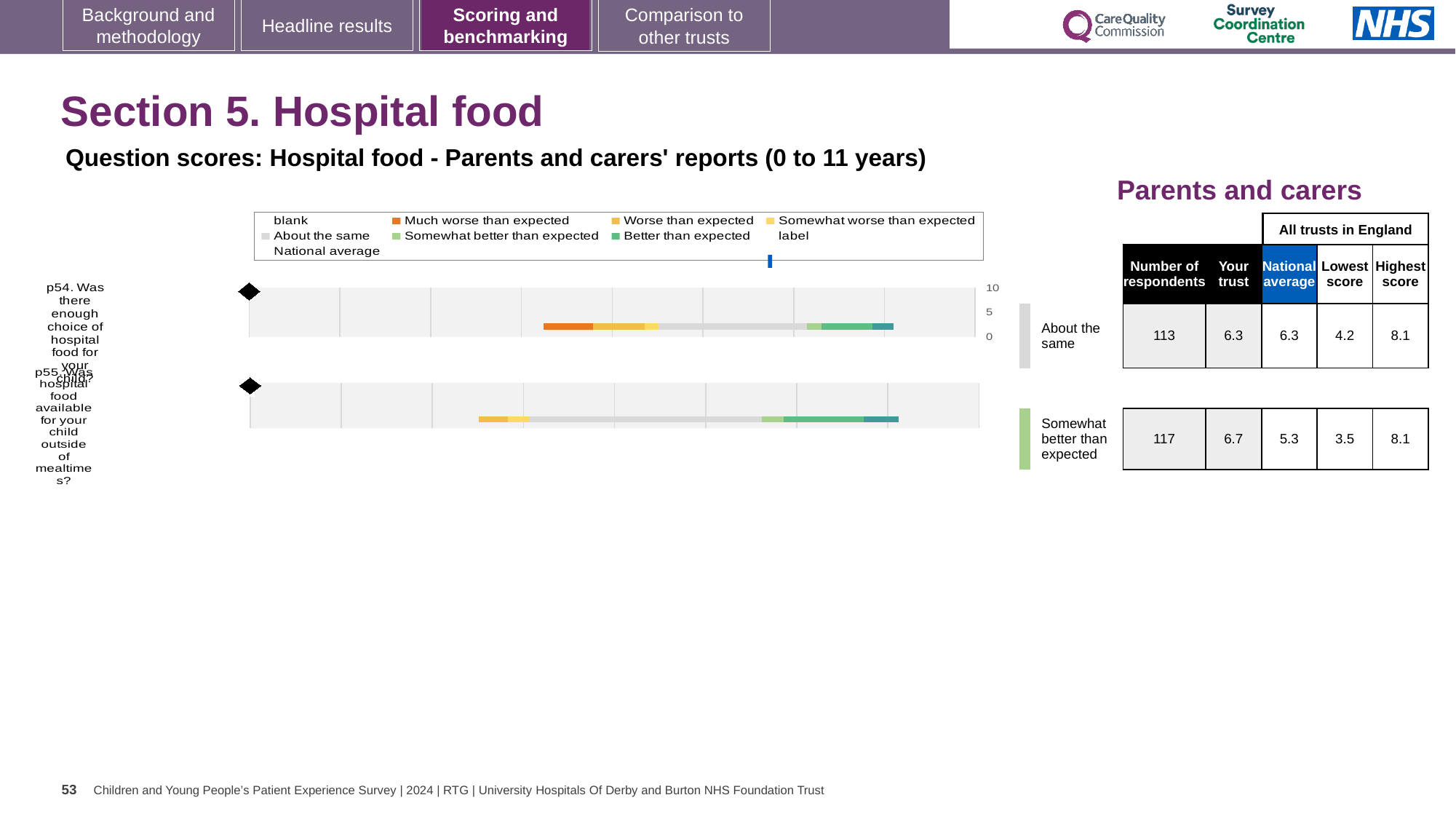
How many respondents answered p54? 113 What is the highest value shown on the chart's score axis? 10 Which legend entry is shown in orange? Much worse than expected What is the difference between the 'Your trust' scores for p55 and p54? 0.4 According to the table beside the chart, what is the 'Your trust' score for p54 (choice of hospital food)? 6.3 What is the lowest score across all trusts in England for p54? 4.2 What is the national average score for p55? 5.3 What kind of chart is used to show the question scores for p54 and p55? bar chart How many survey questions (bars) are plotted in the chart? 2 How many entries does the chart legend list? 9 According to the table beside the chart, what is the 'Your trust' score for p55 (food available outside of mealtimes)? 6.7 Which question has the higher 'Your trust' score, p54 or p55? p55